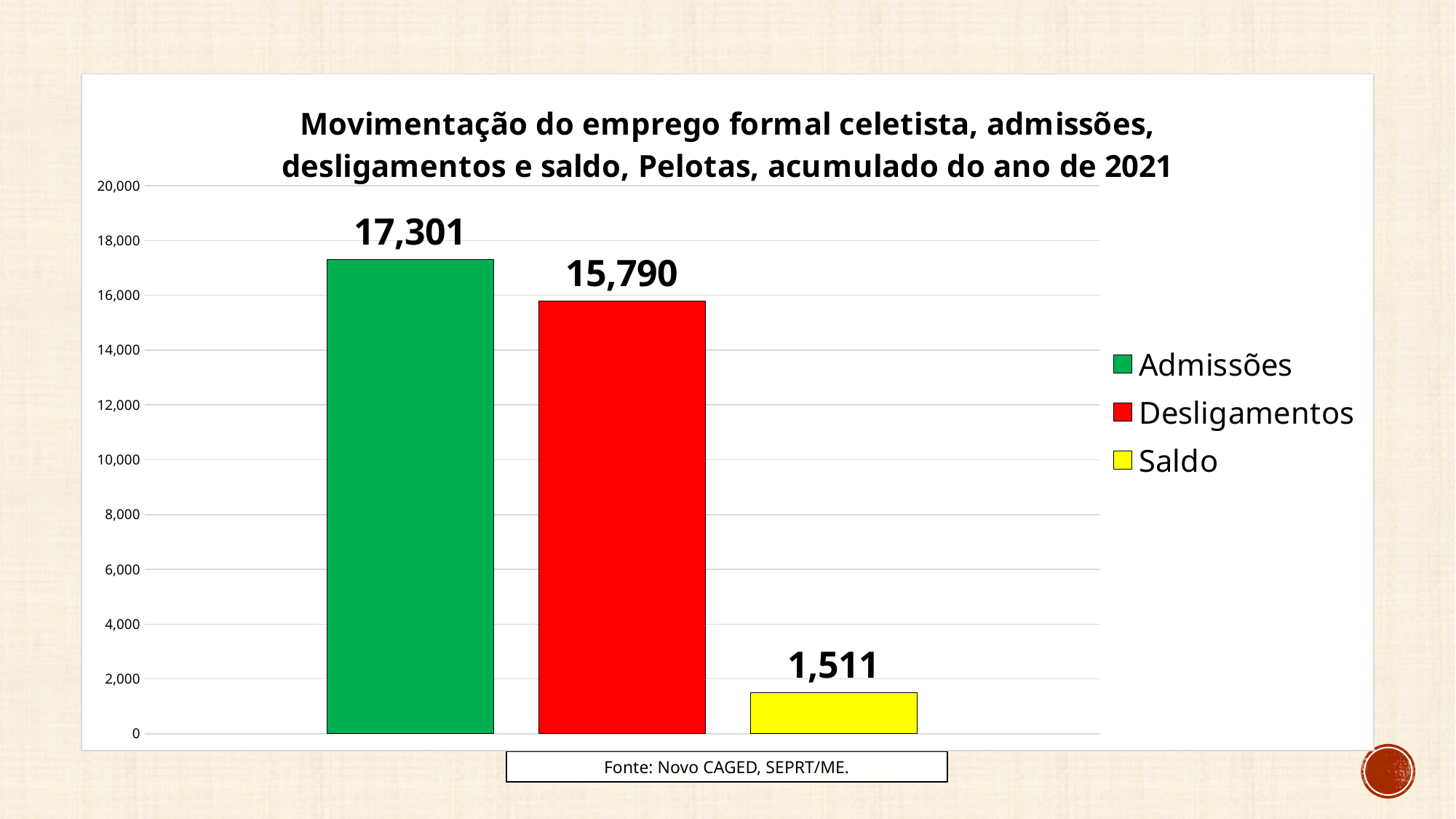
How many series does the legend list? 3 How many bars are plotted in the chart? 3 What is the value for Saldo? 1,511 What is the value for Desligamentos? 15,790 Is the value for Desligamentos greater or less than 16,000? less What colour is the bar for Saldo? yellow Which series has the lowest value? Saldo What is the value for Admissões? 17,301 What is the difference between Admissões and Desligamentos? 1,511 What kind of chart is shown on the slide? bar chart Which series has the highest value? Admissões Which is larger, Desligamentos or Saldo? Desligamentos